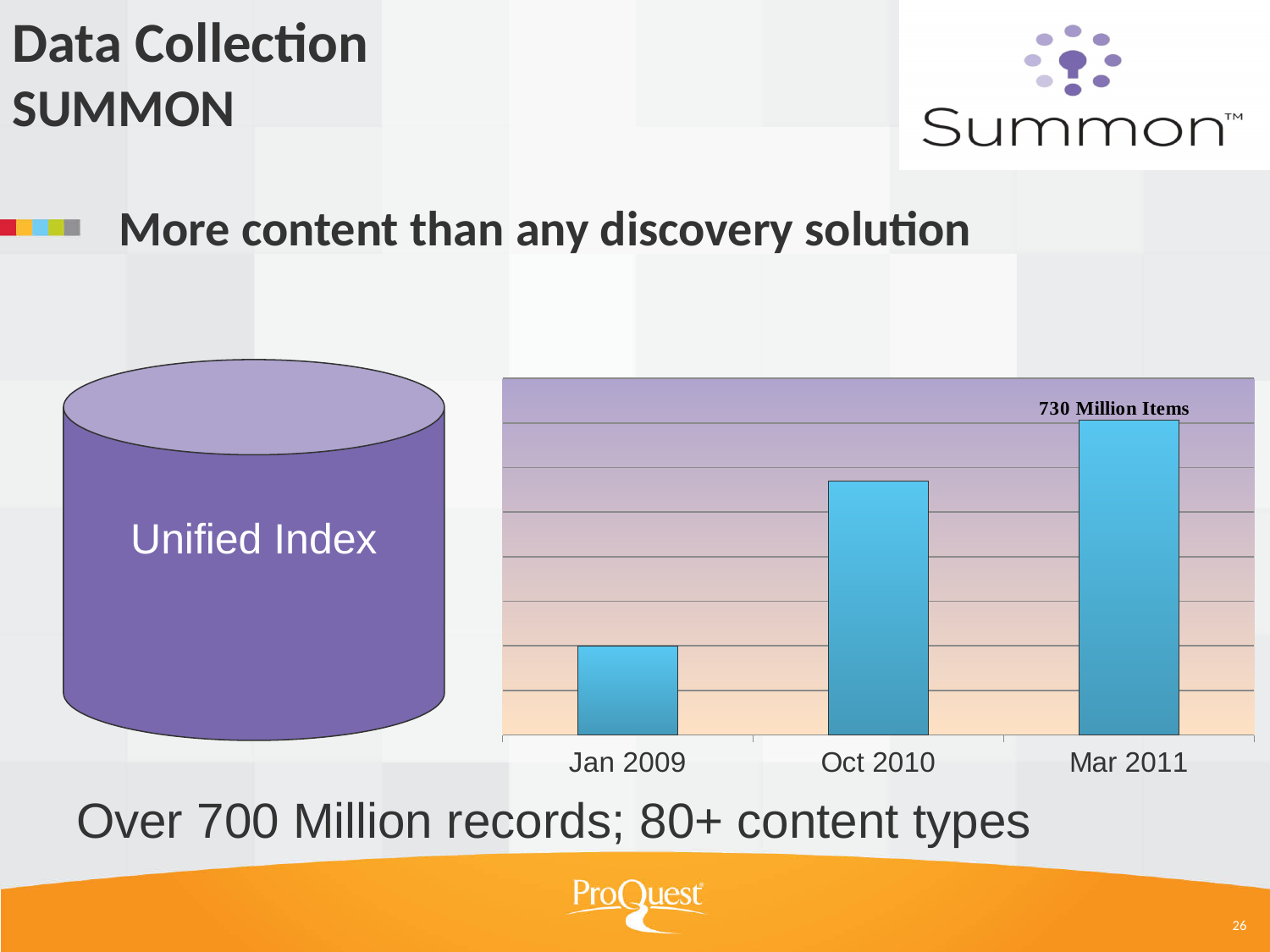
Which category has the highest bar? Mar 2011 What colour are the bars in the chart? blue Which category has the lowest bar? Jan 2009 What is the label of the first category on the x axis? Jan 2009 How many categories are shown on the x axis of the bar chart? 3 What kind of chart is shown on the slide? bar chart Do the bar values rise or fall from Jan 2009 to Mar 2011? rise Which is larger, the bar for Jan 2009 or the bar for Oct 2010? Oct 2010 Which is larger, the bar for Oct 2010 or the bar for Mar 2011? Mar 2011 What value is labelled on the bar for Mar 2011? 730 Million Items